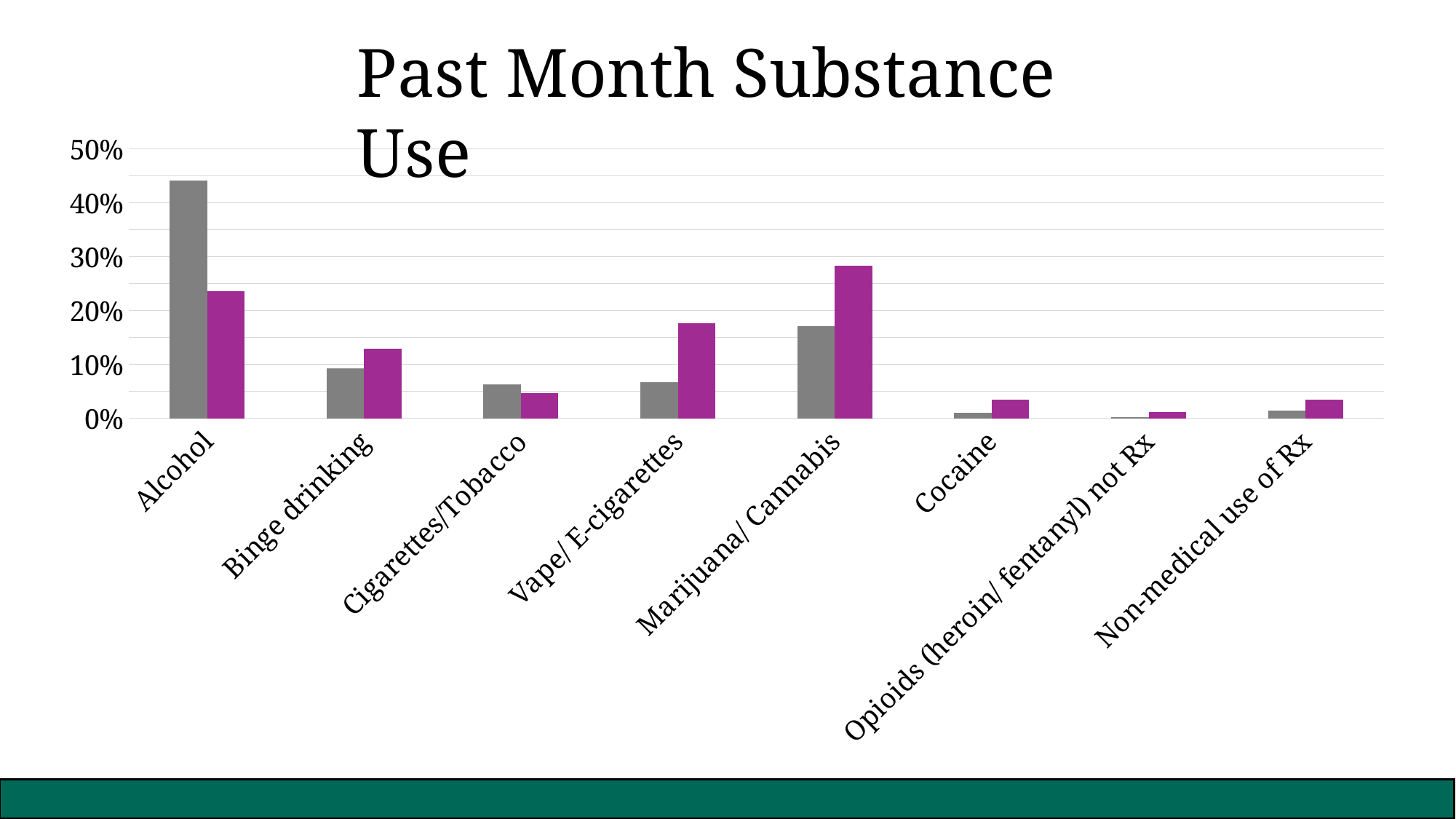
Which category has the shortest gray bar? Opioids (heroin/ fentanyl) not Rx For Vape/ E-cigarettes, which bar is taller, the gray one or the purple one? purple What is the highest value shown on the y axis? 50% Which category has the tallest gray bar? Alcohol How many substance categories are shown on the x axis? 8 What kind of chart is shown on the slide? bar chart What is the title of the chart? Past Month Substance Use Is the purple bar for Marijuana/ Cannabis greater or less than 30%? less Is the purple bar for Binge drinking greater or less than 10%? greater Which category has the tallest purple bar? Marijuana/ Cannabis For Alcohol, which bar is taller, the gray one or the purple one? gray Is the gray bar for Alcohol greater or less than 40%? greater